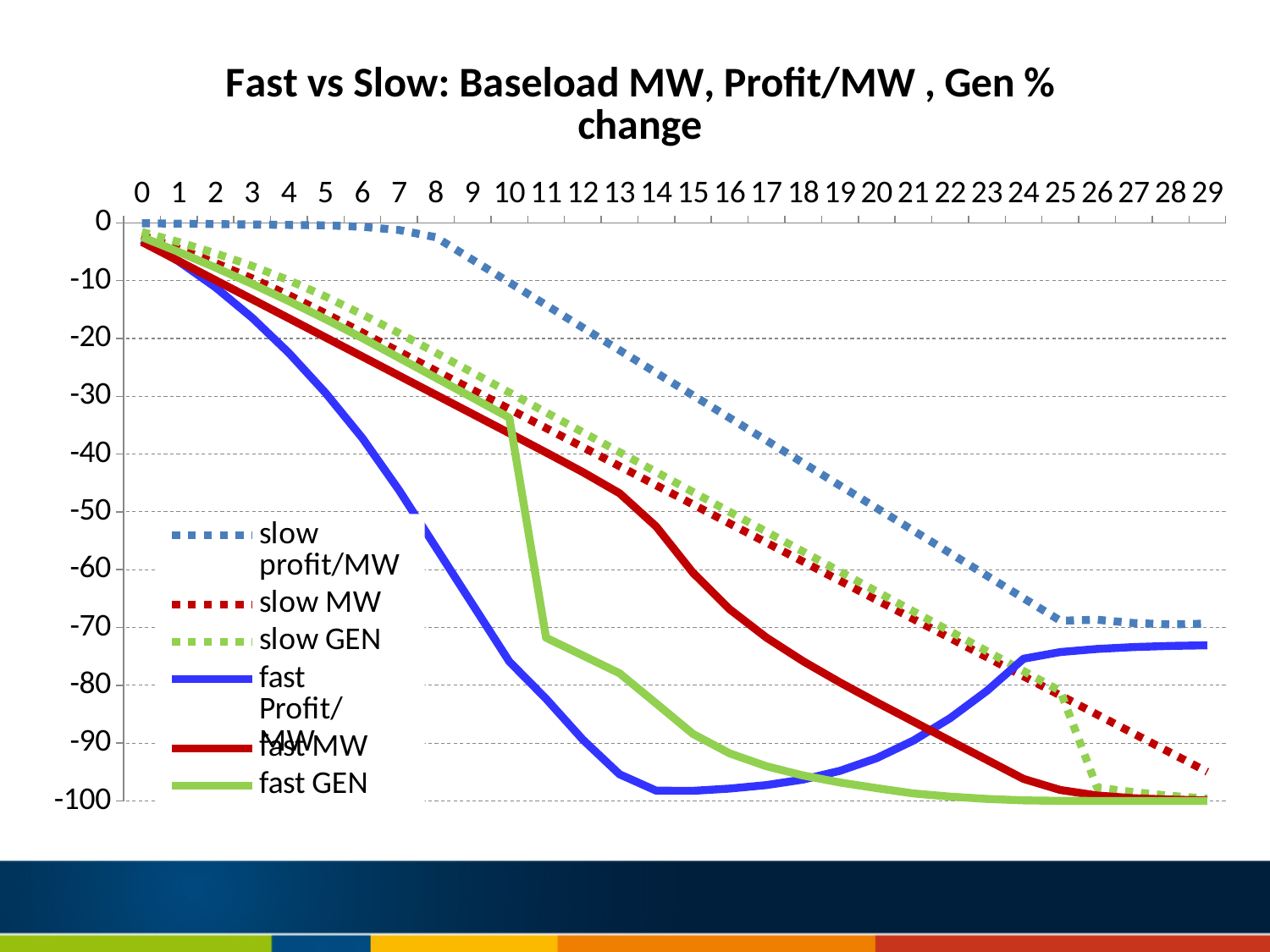
Do the values of the slow profit/MW series rise or fall as the x axis goes from 0 to 29? fall How many series does the legend list? 6 Which series has the highest value at x = 29? slow profit/MW Is the value for fast GEN at x = 11 greater or less than -50? less What kind of chart is shown on the slide? line chart Is the value for slow profit/MW at x = 8 greater or less than -10? greater How many points are labelled along the x axis? 30 At x = 14, which series has the higher value, slow profit/MW or fast Profit/MW? slow profit/MW Is the value for slow profit/MW at x = 29 greater or less than -80? greater Which series has the lowest value at x = 14? fast Profit/MW What is the title of the chart? Fast vs Slow: Baseload MW, Profit/MW , Gen % change